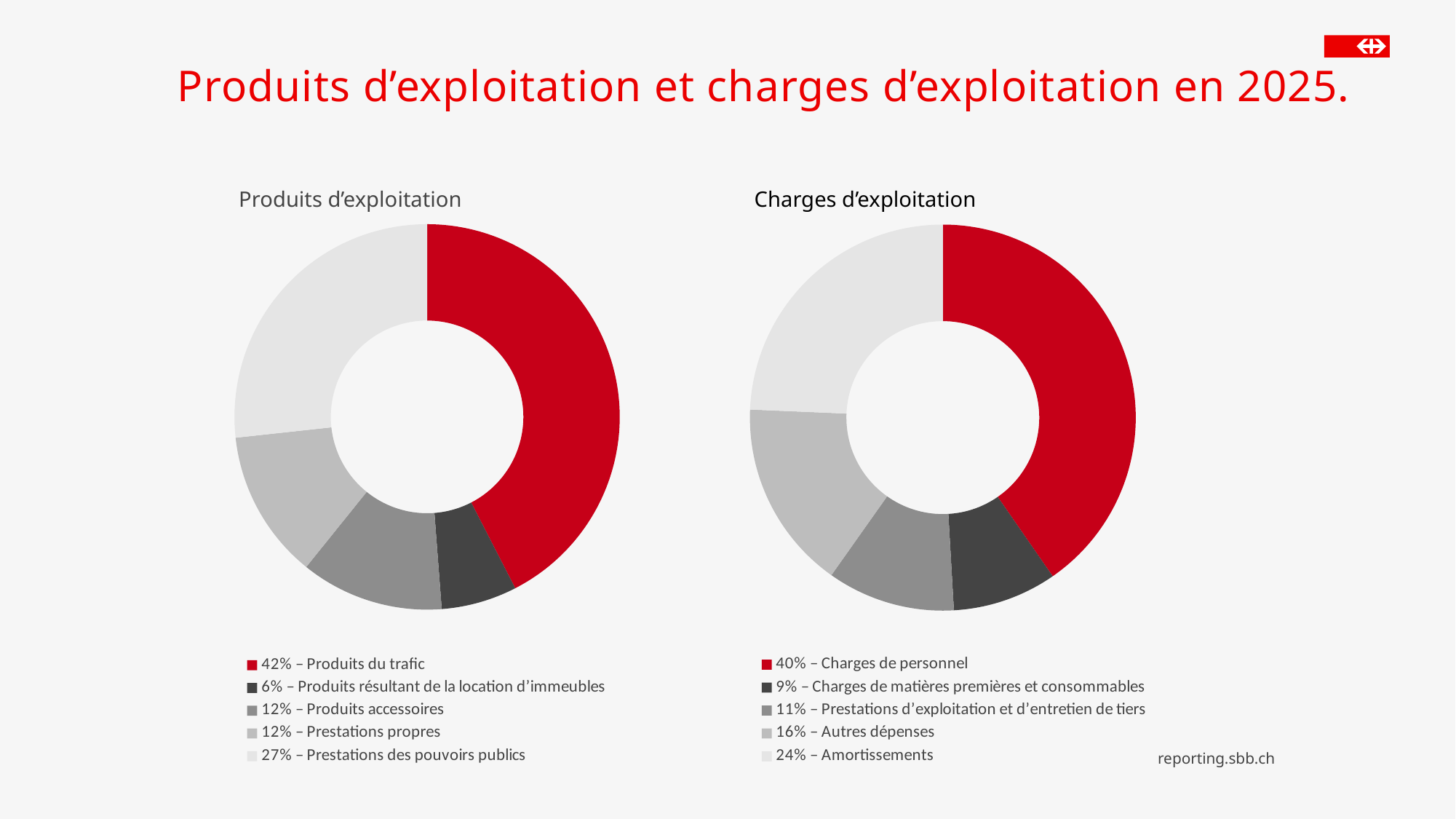
In the 'Produits d'exploitation' chart, which category has the largest share? Produits du trafic In the 'Charges d'exploitation' chart, what share is 'Prestations d'exploitation et d'entretien de tiers'? 11% In the 'Charges d'exploitation' chart, which is larger: 'Autres dépenses' or 'Prestations d'exploitation et d'entretien de tiers'? Autres dépenses In the 'Charges d'exploitation' chart, which category has the smallest share? Charges de matières premières et consommables What is the title of the slide? Produits d'exploitation et charges d'exploitation en 2025. What kind of chart is the 'Charges d'exploitation' chart? Doughnut chart In the 'Charges d'exploitation' chart, what is the difference between 'Charges de personnel' and 'Amortissements'? 16% In the 'Produits d'exploitation' chart, which category has the smallest share? Produits résultant de la location d'immeubles In the 'Charges d'exploitation' chart, what share is 'Amortissements'? 24% In the 'Produits d'exploitation' chart, what share is 'Produits du trafic'? 42% How many categories does the 'Produits d'exploitation' chart show? 5 In the 'Produits d'exploitation' chart, what is the difference between 'Prestations des pouvoirs publics' and 'Produits accessoires'? 15%